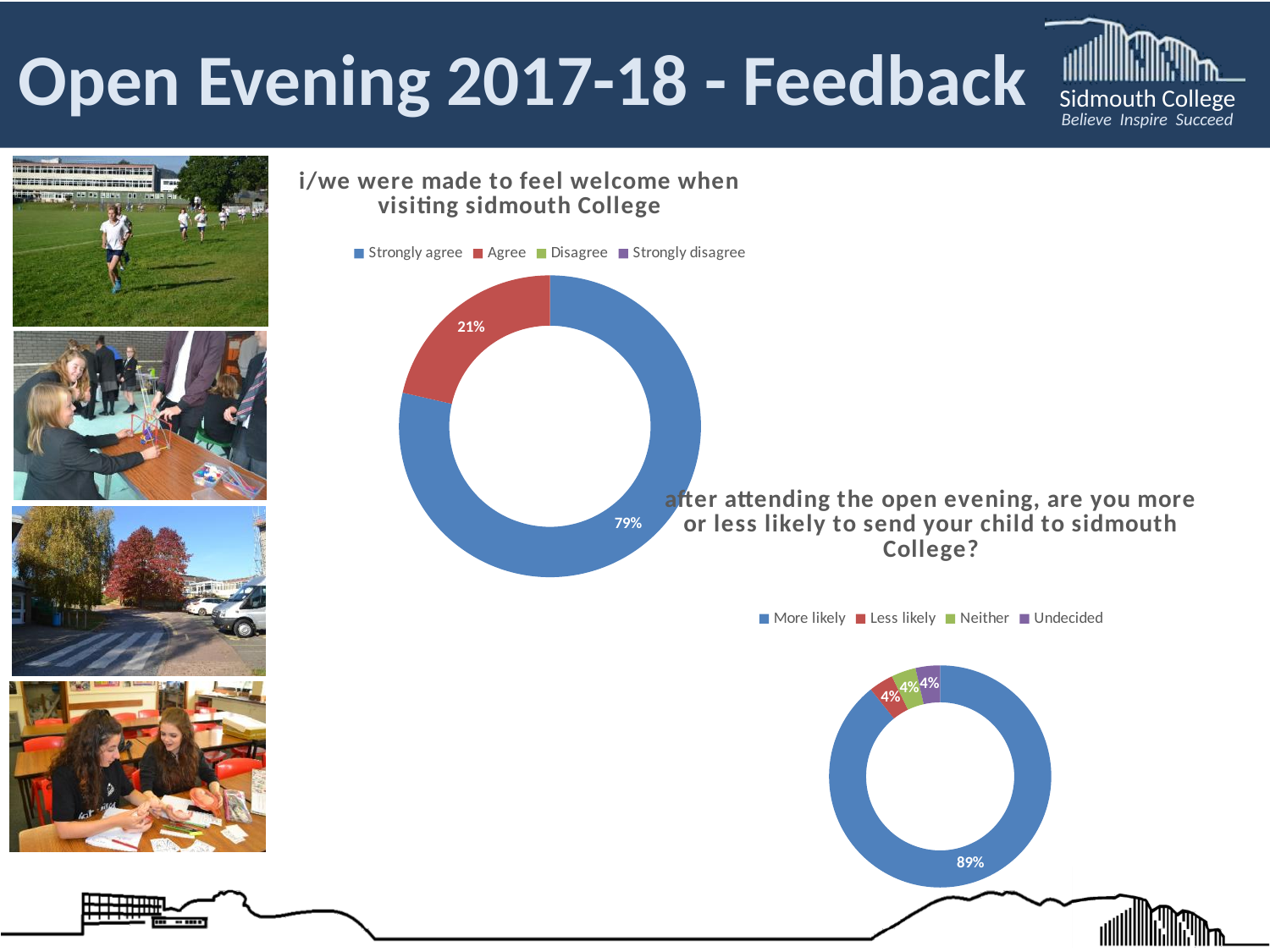
In the chart titled "after attending the open evening, are you more or less likely to send your child to sidmouth College?", how many percentage points larger is More likely than Undecided? 85 In the chart titled "after attending the open evening, are you more or less likely to send your child to sidmouth College?", what percentage is shown for Less likely? 4% In the chart titled "after attending the open evening, are you more or less likely to send your child to sidmouth College?", which response has the largest share? More likely In the chart titled "i/we were made to feel welcome when visiting sidmouth College", what percentage is shown for Strongly agree? 79% In the chart titled "after attending the open evening, are you more or less likely to send your child to sidmouth College?", how many slices have a data label shown? 4 In the chart titled "i/we were made to feel welcome when visiting sidmouth College", what percentage is shown for Agree? 21% In the chart titled "after attending the open evening, are you more or less likely to send your child to sidmouth College?", what percentage is shown for More likely? 89% How many entries does the legend of the chart titled "i/we were made to feel welcome when visiting sidmouth College" list? 4 In the chart titled "i/we were made to feel welcome when visiting sidmouth College", which response has the largest share? Strongly agree In the chart titled "after attending the open evening, are you more or less likely to send your child to sidmouth College?", which legend entry is shown in green? Neither In the chart titled "i/we were made to feel welcome when visiting sidmouth College", how many percentage points larger is Strongly agree than Agree? 58 What kind of chart is the chart titled "i/we were made to feel welcome when visiting sidmouth College"? Doughnut chart